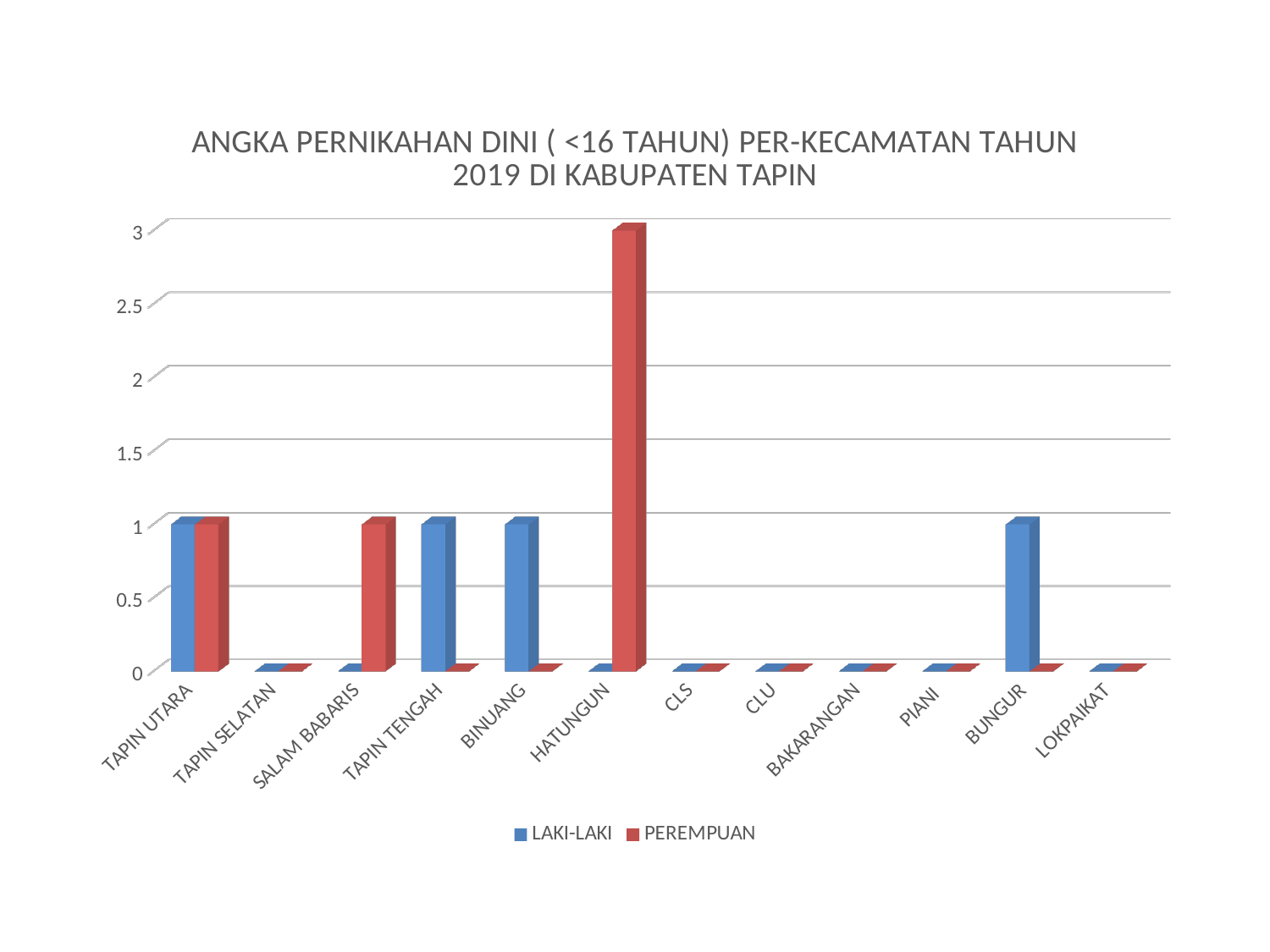
How many kecamatan (categories) are shown on the x axis? 12 What is the LAKI-LAKI value for BUNGUR? 1 What kind of chart is shown on the slide? bar chart How many series does the legend list? 2 Which kecamatan has the highest PEREMPUAN value? HATUNGUN What is the PEREMPUAN value for SALAM BABARIS? 1 What is the difference between the PEREMPUAN value for HATUNGUN and the PEREMPUAN value for TAPIN UTARA? 2 Which is larger, the LAKI-LAKI value for BINUANG or the PEREMPUAN value for BINUANG? LAKI-LAKI What is the PEREMPUAN value for HATUNGUN? 3 Which colour represents the PEREMPUAN series? red Is the PEREMPUAN value for HATUNGUN greater or less than 2? greater What is the LAKI-LAKI value for HATUNGUN? 0